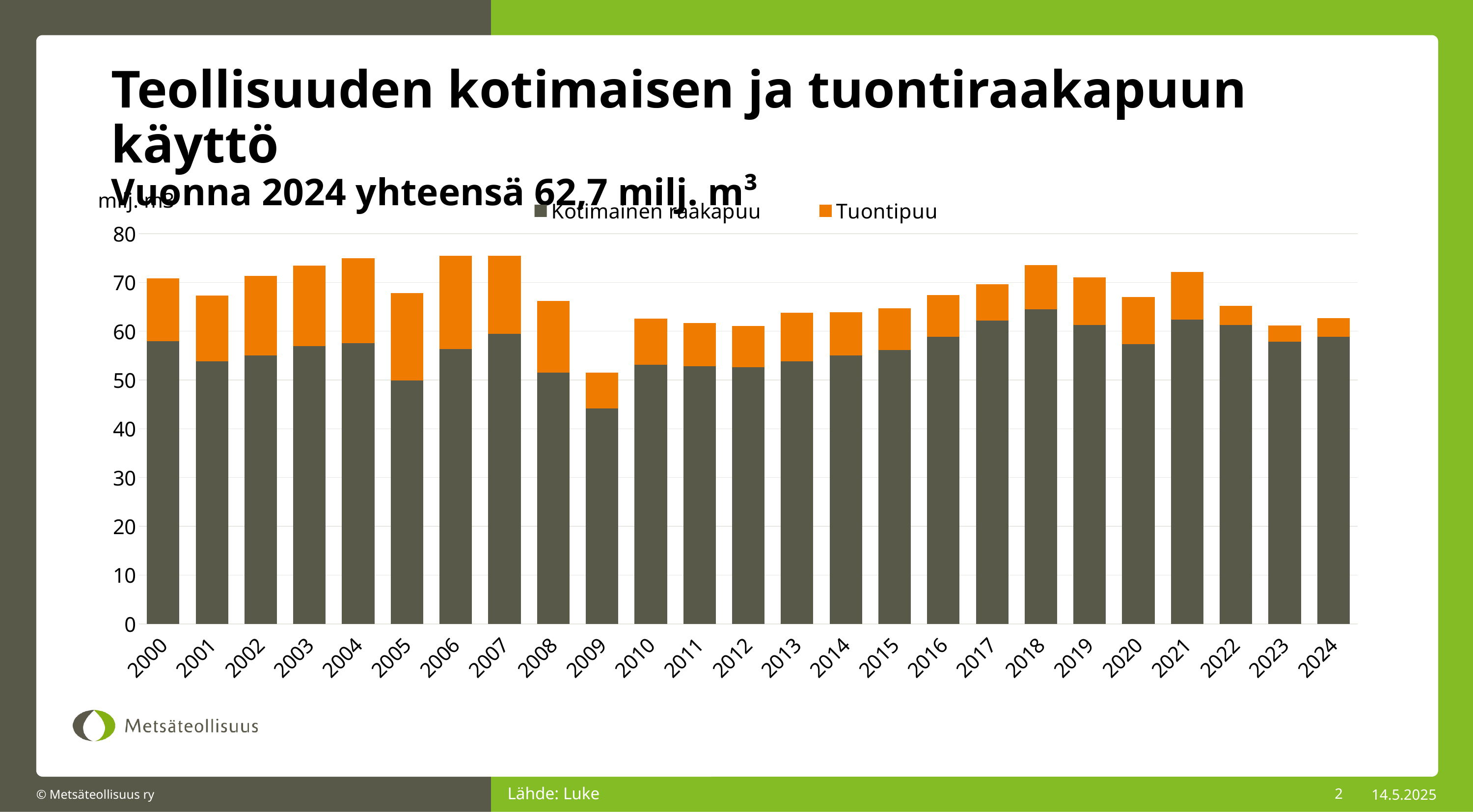
How many series does the chart legend list? 2 Is the Kotimainen raakapuu value for 2009 greater or less than 50? less Is the total bar for 2009 greater or less than 60? less How many years (bars) are shown on the x axis of the chart? 25 Which colour represents Tuontipuu in the chart? Orange According to the slide, what was the total use of domestic and imported roundwood in 2024? 62,7 milj. m³ What is the unit shown on the y axis of the chart? milj. m³ Is the total bar for 2018 greater or less than 70? greater What kind of chart is shown on the slide? Stacked bar chart Do the total bars rise or fall from 2021 to 2023? fall Which year has the lowest total bar in the chart? 2009 Which year has the larger total bar, 2009 or 2018? 2018